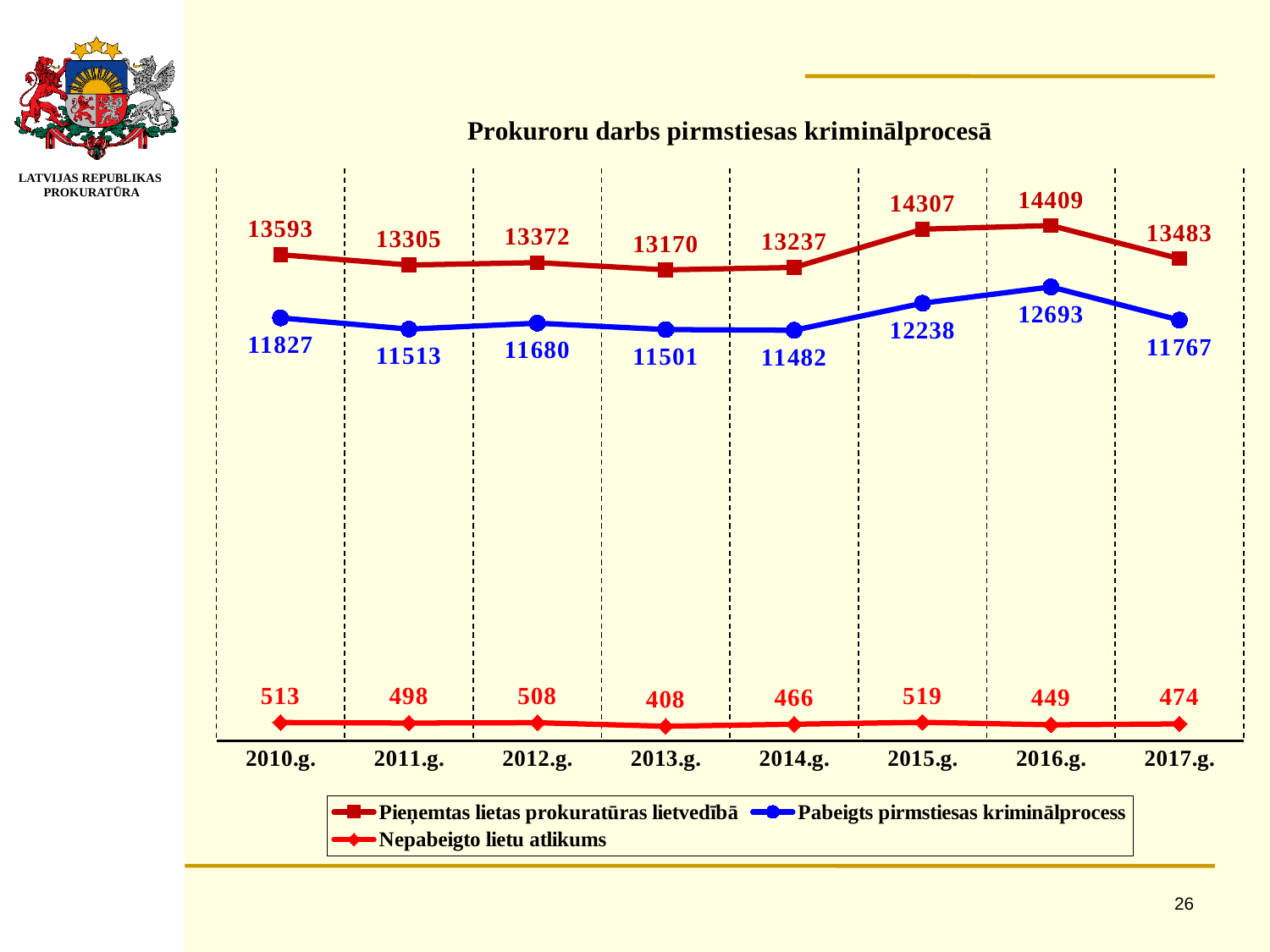
What kind of chart is shown on the slide? Line chart In which year is "Pieņemtas lietas prokuratūras lietvedībā" highest? 2016.g. What is the title of the chart? Prokuroru darbs pirmstiesas kriminālprocesā How many years are shown on the x axis? 8 What is the value of "Pieņemtas lietas prokuratūras lietvedībā" in 2016.g.? 14409 Which is larger: "Nepabeigto lietu atlikums" in 2011.g. or in 2012.g.? 2012.g. In which year is "Nepabeigto lietu atlikums" highest? 2015.g. How many series does the legend list? 3 What is the value of "Nepabeigto lietu atlikums" in 2013.g.? 408 What is the difference between "Pieņemtas lietas prokuratūras lietvedībā" and "Pabeigts pirmstiesas kriminālprocess" in 2010.g.? 1766 In which year is "Pabeigts pirmstiesas kriminālprocess" lowest? 2014.g. What is the value of "Pabeigts pirmstiesas kriminālprocess" in 2014.g.? 11482